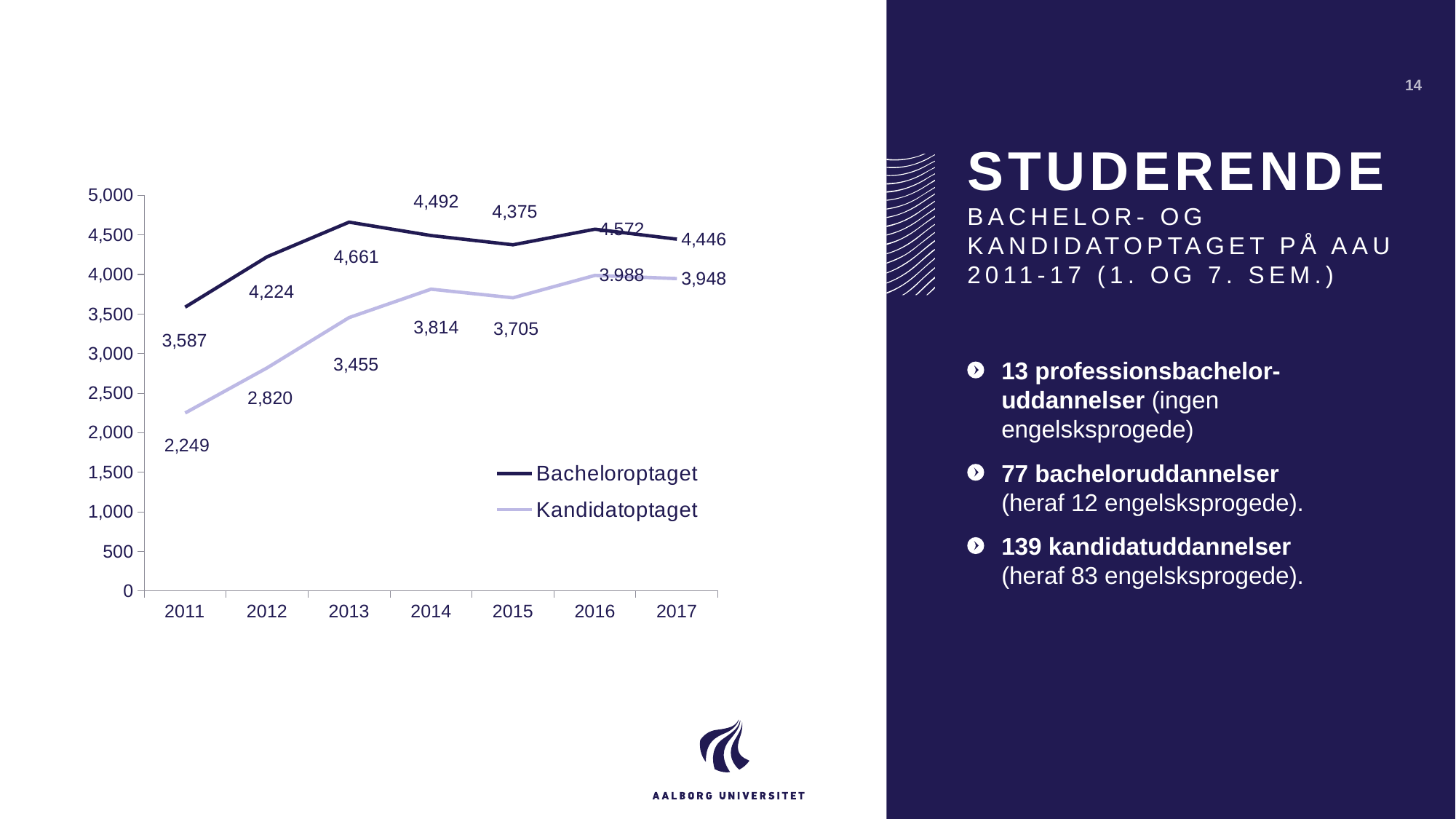
In which year is Bacheloroptaget highest? 2013 How many series does the chart legend list? 2 In which year is Kandidatoptaget lowest? 2011 What is the value of Bacheloroptaget in 2013? 4,661 Does Kandidatoptaget rise or fall from 2011 to 2014? rise How many years are plotted on the x axis of the chart? 7 What is the difference between Bacheloroptaget and Kandidatoptaget in 2017? 498 Which is larger, Kandidatoptaget in 2014 or Kandidatoptaget in 2015? 2014 What type of chart is shown on the slide? line chart What is the value of Kandidatoptaget in 2011? 2,249 What is the value of Kandidatoptaget in 2016? 3,988 Which series is drawn with the lighter line in the chart? Kandidatoptaget